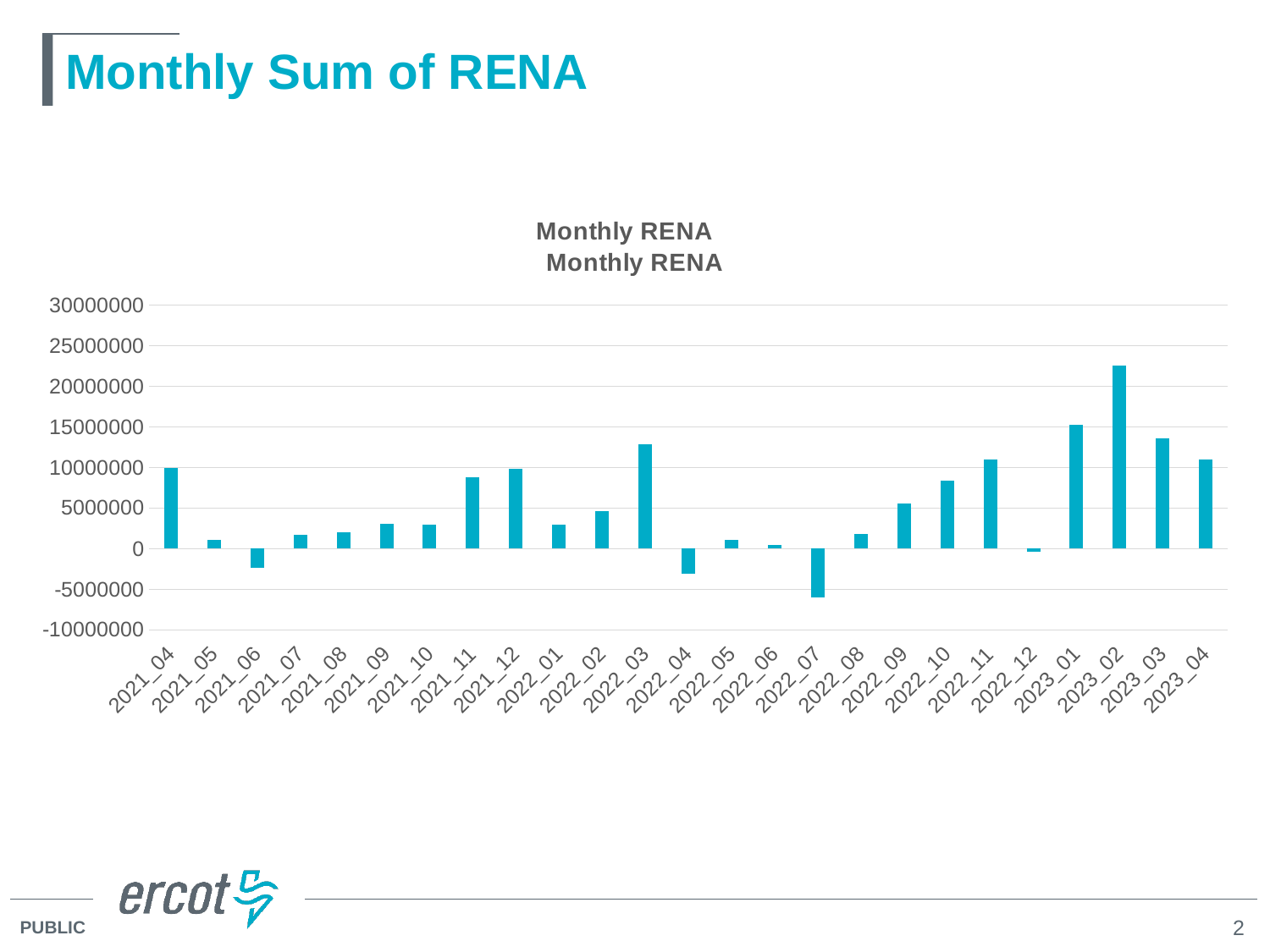
Is the value for 2021_06 greater or less than 0? less Which is larger, the value for 2022_03 or the value for 2022_01? 2022_03 Which is larger, the value for 2023_02 or the value for 2023_03? 2023_02 Which month has the highest Monthly RENA value? 2023_02 Is the value for 2023_02 greater or less than 20000000? greater Is the value for 2022_03 greater or less than 10000000? greater Which month has the lowest Monthly RENA value? 2022_07 How many months are plotted on the x axis? 25 What kind of chart is shown on the slide? bar chart What is the title of the chart? Monthly RENA